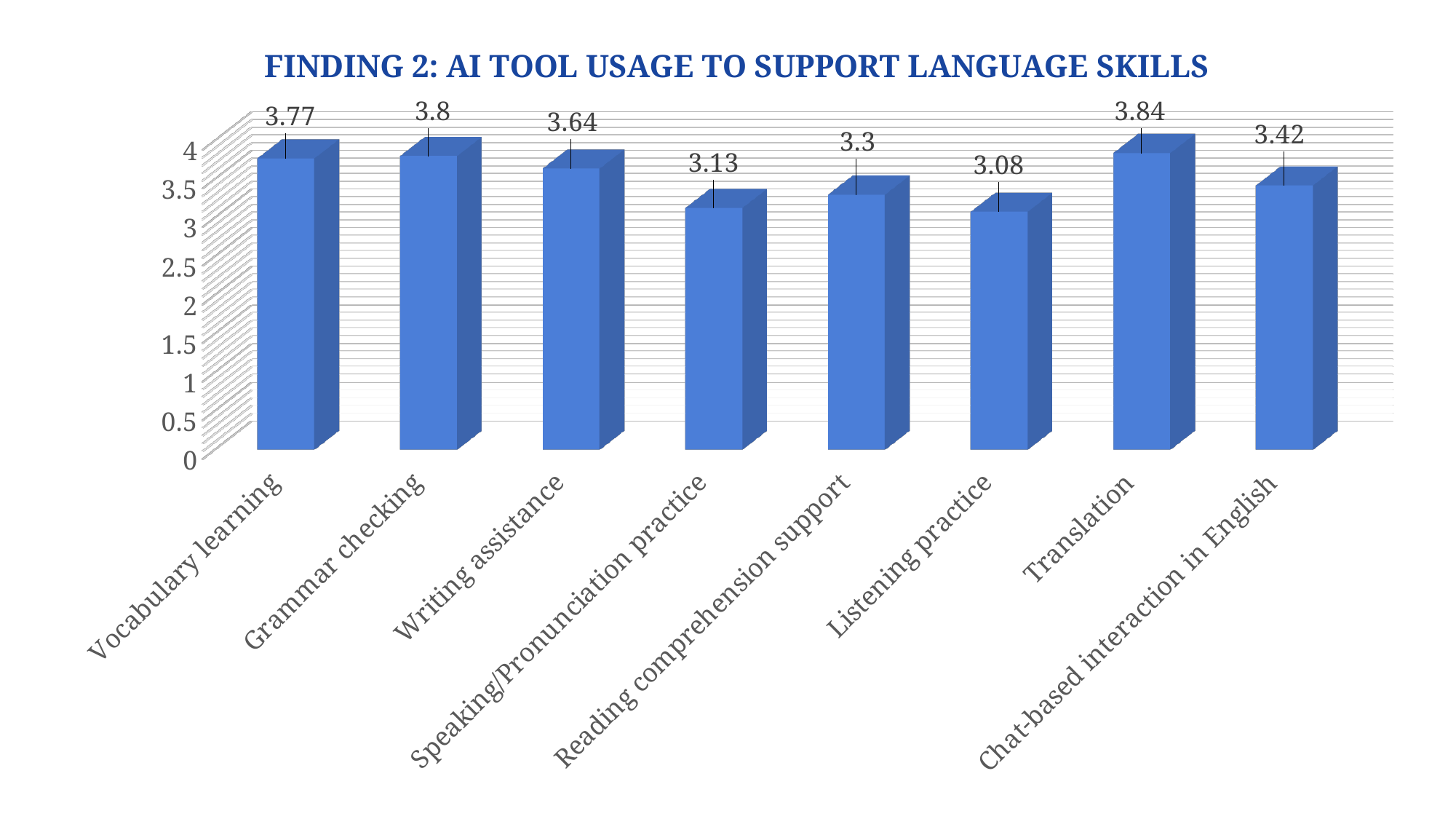
What is the difference between the values for Translation and Listening practice? 0.76 How many categories are shown in the chart? 8 What is the value for Vocabulary learning? 3.77 What is the value for Reading comprehension support? 3.3 What kind of chart is shown on the slide? bar chart What is the difference between the values for Grammar checking and Writing assistance? 0.16 Is the value for Writing assistance greater or less than 3.5? greater What is the title of the chart? FINDING 2: AI TOOL USAGE TO SUPPORT LANGUAGE SKILLS What is the value for Chat-based interaction in English? 3.42 Which category has the highest value? Translation Which category has the lowest value? Listening practice Which is larger, the value for Speaking/Pronunciation practice or the value for Chat-based interaction in English? Chat-based interaction in English